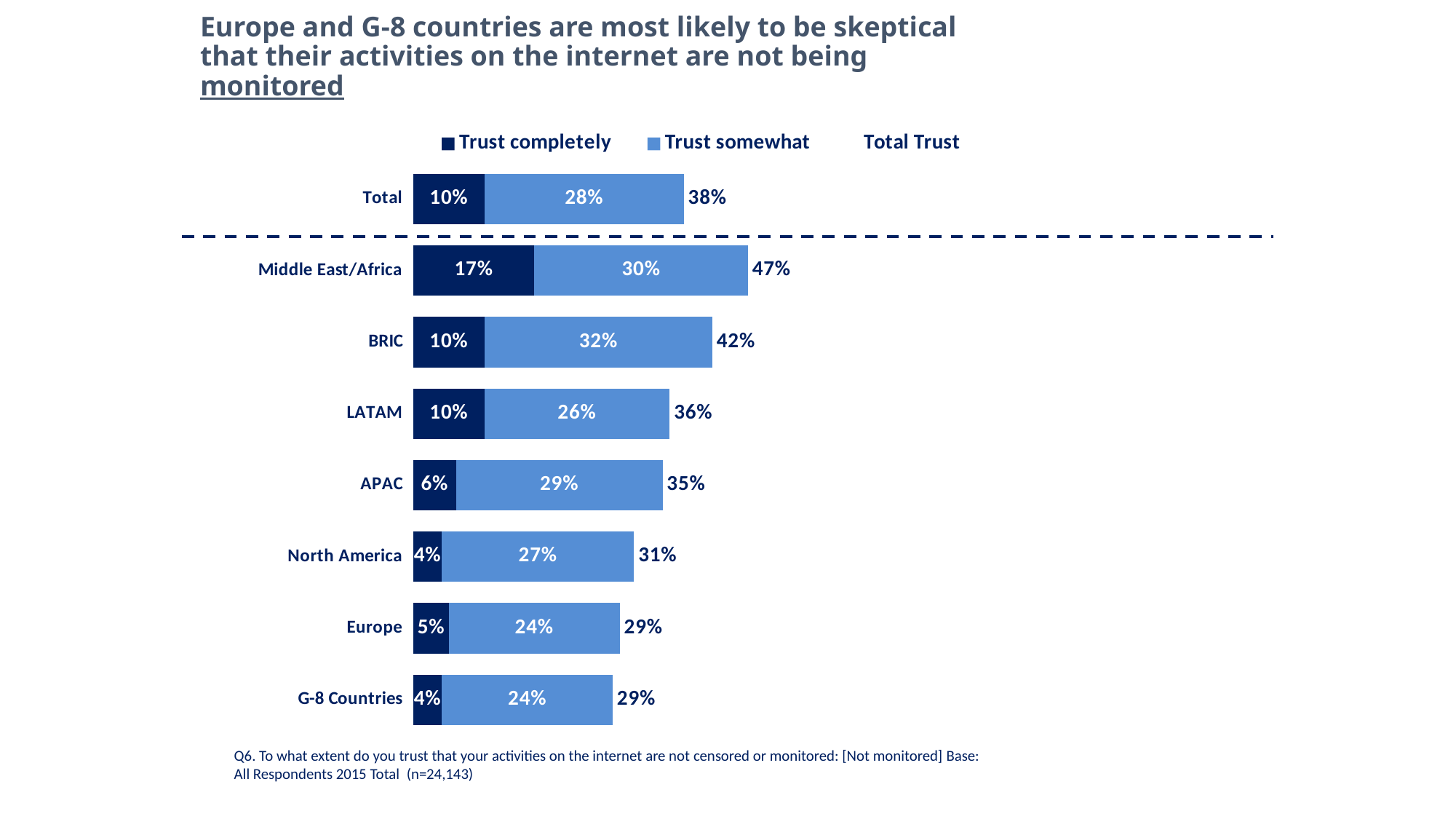
Which colour represents 'Trust completely' in the chart? Dark navy blue How many series does the legend list? 3 Which region has the highest Total Trust? Middle East/Africa What is the difference in Total Trust between Middle East/Africa and Europe? 18 percentage points What is the Total Trust value for North America? 31% What is the 'Trust completely' value for Middle East/Africa? 17% What kind of chart is shown on the slide? Stacked horizontal bar chart Which region has the lowest 'Trust somewhat' value? Europe and G-8 Countries (both 24%) Which has a higher 'Trust completely' value, APAC or Europe? APAC What is the 'Trust somewhat' value for BRIC? 32% How many regional categories are shown below the dashed line? 7 What is the total of the stacked bar for LATAM? 36%